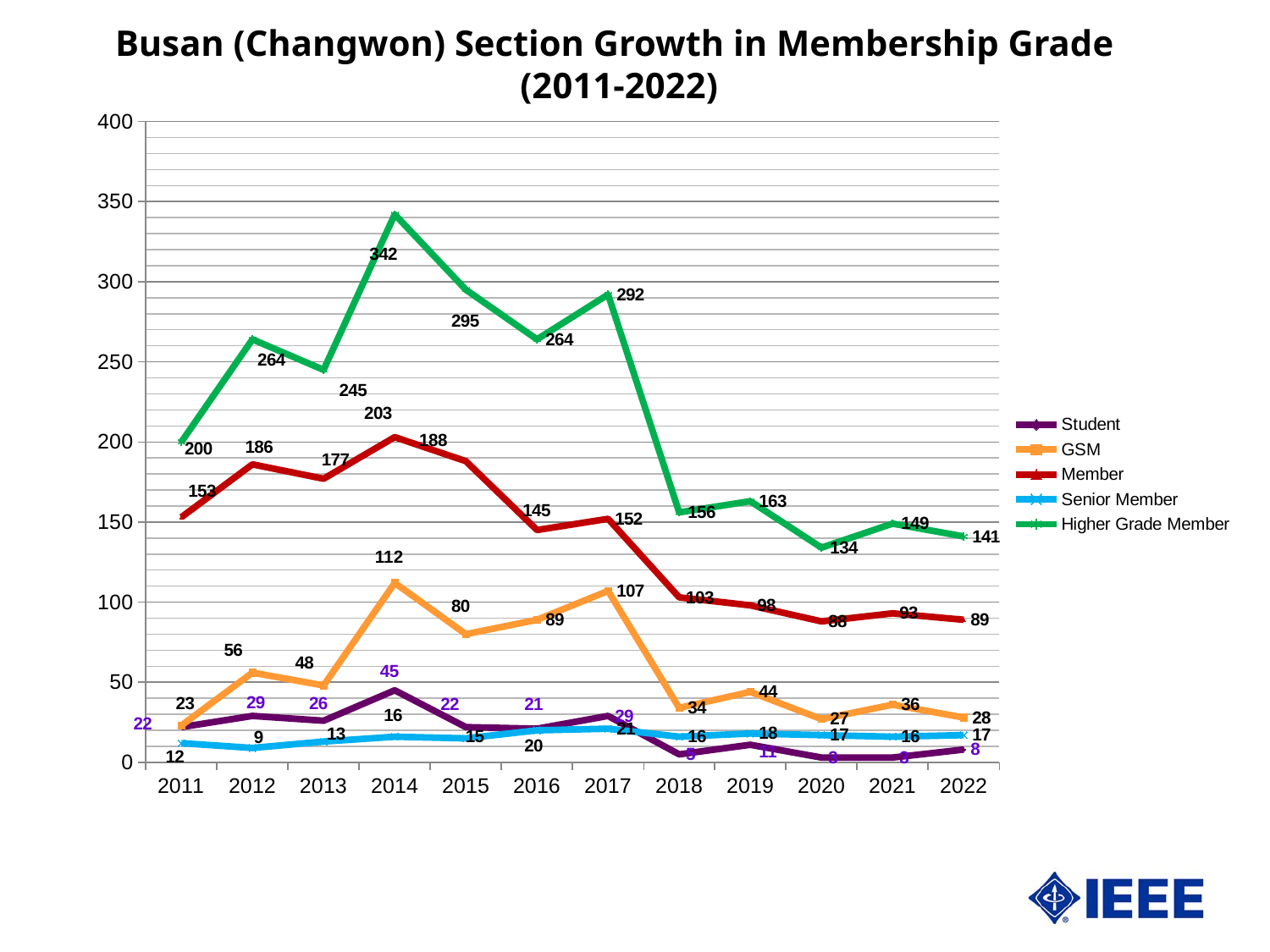
How many series does the legend list? 5 In which year is the Member series at its lowest value? 2020 What is the value for Senior Member in 2016? 20 What is the value for Member in 2011? 153 What kind of chart is shown on the slide? line chart In which year does the Higher Grade Member series reach its highest value? 2014 What is the value for Higher Grade Member in 2014? 342 How many years are plotted along the x axis? 12 Does the Higher Grade Member series rise or fall from 2017 to 2018? fall What is the difference between the GSM values in 2014 and 2013? 64 What colour is the Higher Grade Member line? green Which year has the larger Member value, 2012 or 2013? 2012